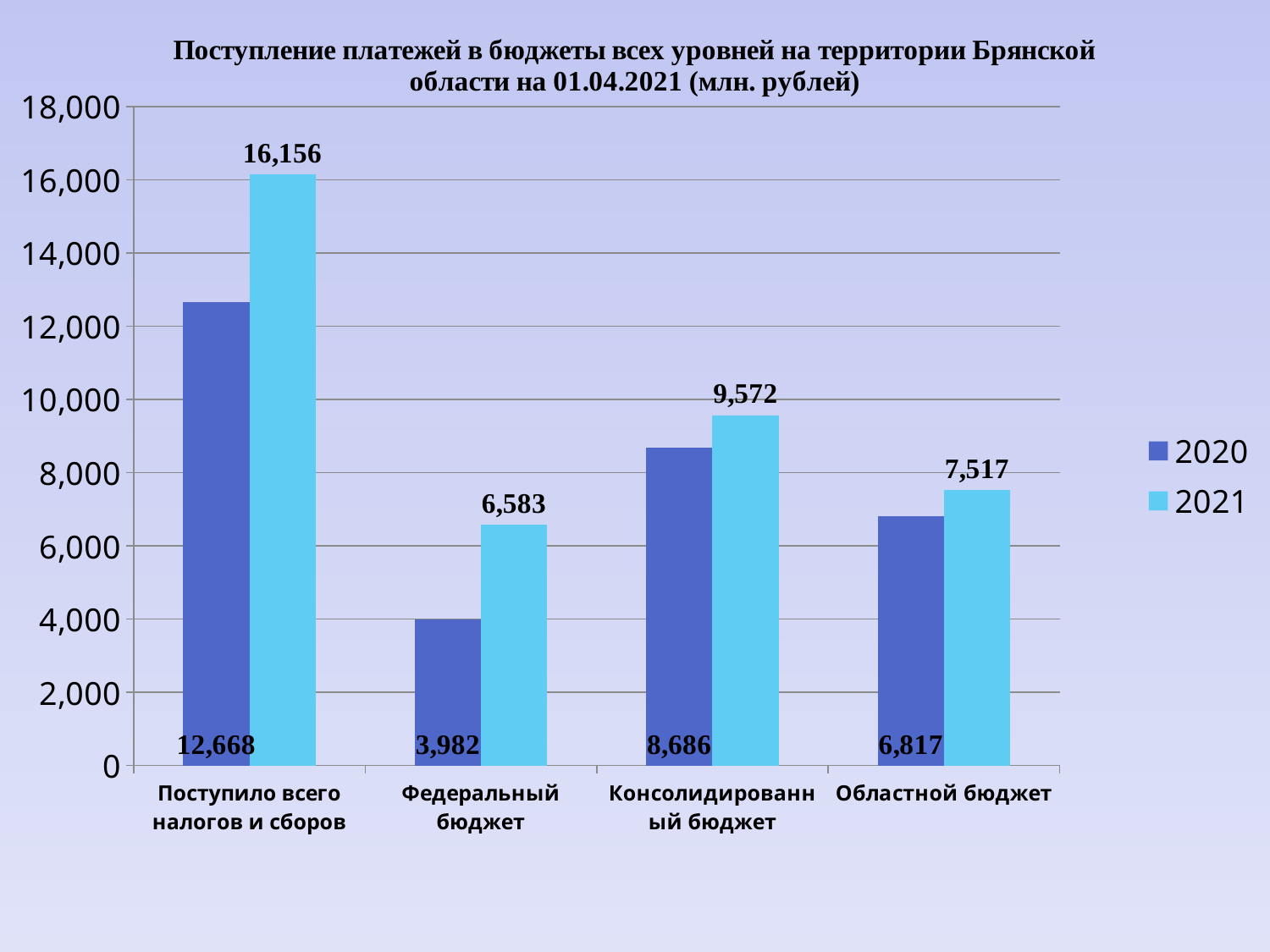
What kind of chart is shown on the slide? Bar chart How many categories are shown on the x axis? 4 What is the 2020 value for Областной бюджет? 6,817 What is the 2021 value for Поступило всего налогов и сборов? 16,156 How many series does the legend list? 2 Which is larger for Областной бюджет: the 2020 value or the 2021 value? 2021 Which category has the highest 2021 value? Поступило всего налогов и сборов What is the difference between the 2021 and 2020 values for Федеральный бюджет? 2,601 What is the 2021 value for Консолидированный бюджет? 9,572 Which category has the lowest 2020 value? Федеральный бюджет What is the difference between the 2021 and 2020 values for Поступило всего налогов и сборов? 3,488 What is the 2020 value for Федеральный бюджет? 3,982